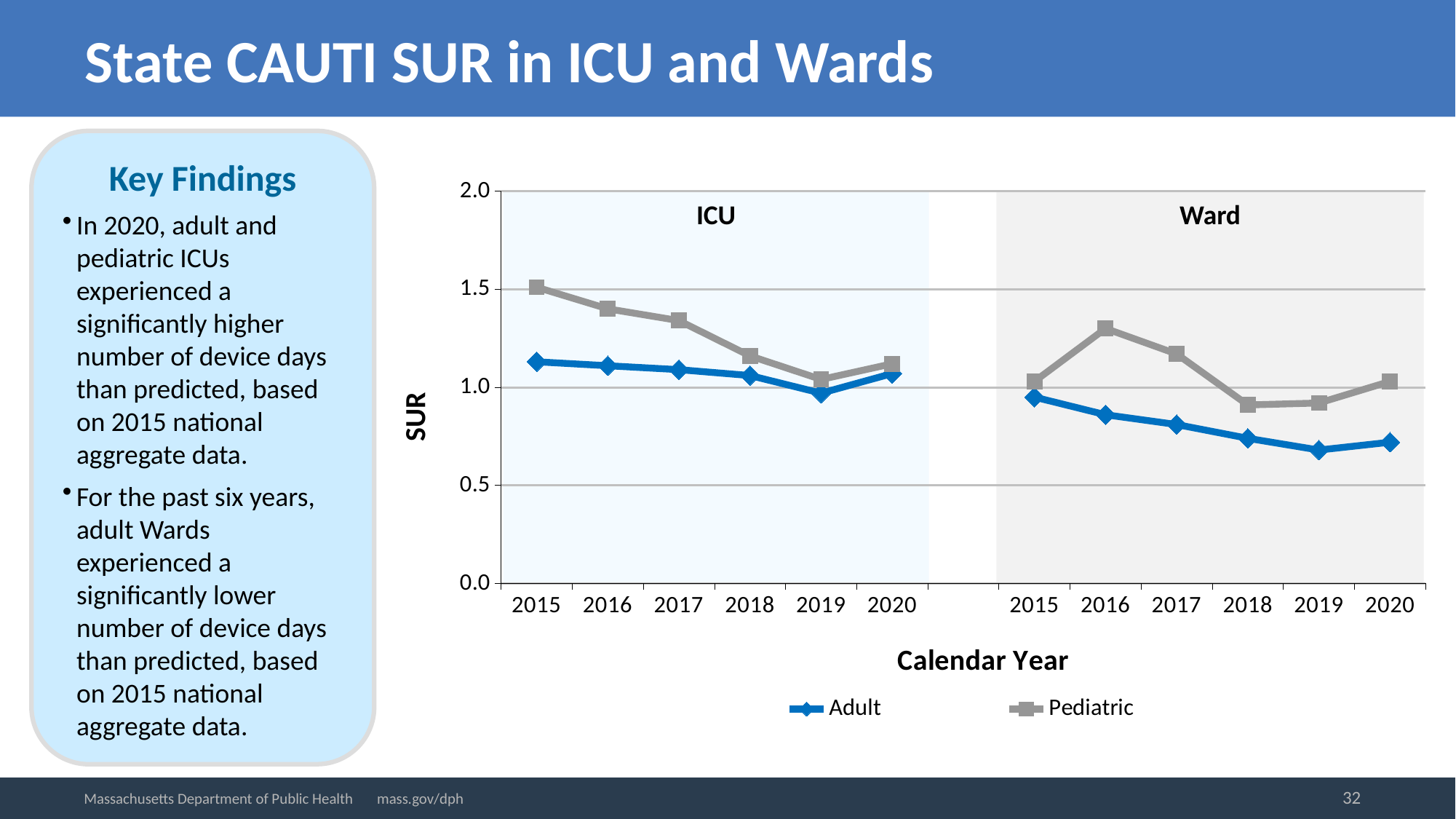
How many calendar years are plotted in the ICU panel? 6 In the ICU panel, is the Pediatric SUR for 2015 greater or less than 1.0? greater In the Ward panel for 2018, which series has the higher SUR, Adult or Pediatric? Pediatric In the Ward panel, is the Adult SUR for 2019 greater or less than 1.0? less What kind of chart is shown on the slide? line chart In the Ward panel, does the Adult SUR rise or fall from 2015 to 2019? fall In the ICU panel, which year has the highest Pediatric SUR? 2015 In the ICU panel for 2015, which series has the higher SUR, Adult or Pediatric? Pediatric In the Ward panel, which year has the highest Pediatric SUR? 2016 What is the title of the x axis? Calendar Year How many series does the legend list? 2 In the Ward panel, is the Pediatric SUR for 2016 greater or less than 1.0? greater